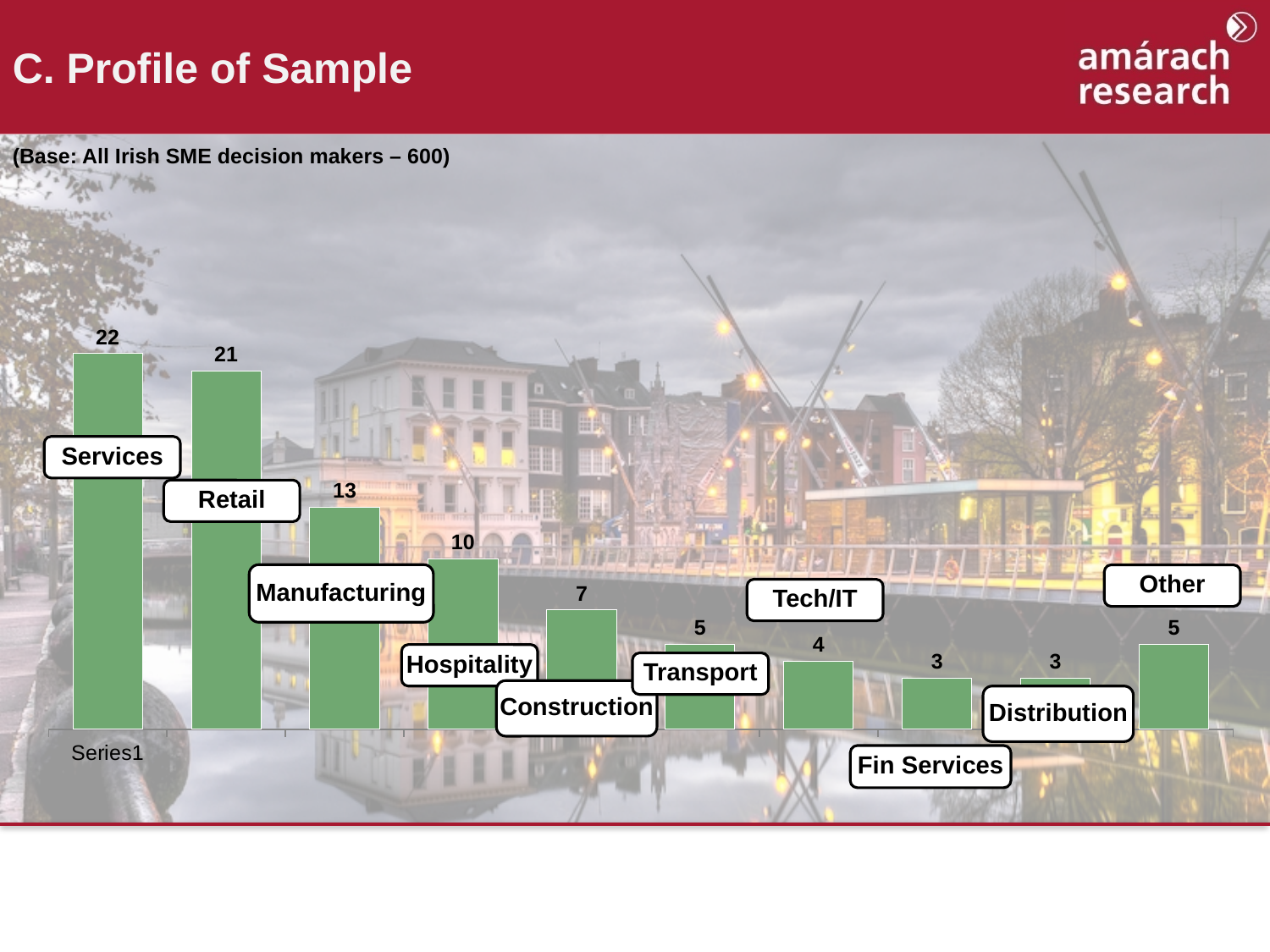
What is the value for Retail? 21 What is the difference between the values for Services and Manufacturing? 9 What kind of chart is shown on the slide? bar chart What is the value for Tech/IT? 4 Which category has the highest value? Services What is the value for Services? 22 What is the base stated above the chart? All Irish SME decision makers – 600 What is the value for Construction? 7 Which is larger, the value for Transport or the value for Tech/IT? Transport What is the value for Hospitality? 10 What is the value for Manufacturing? 13 How many categories are shown in the chart? 10